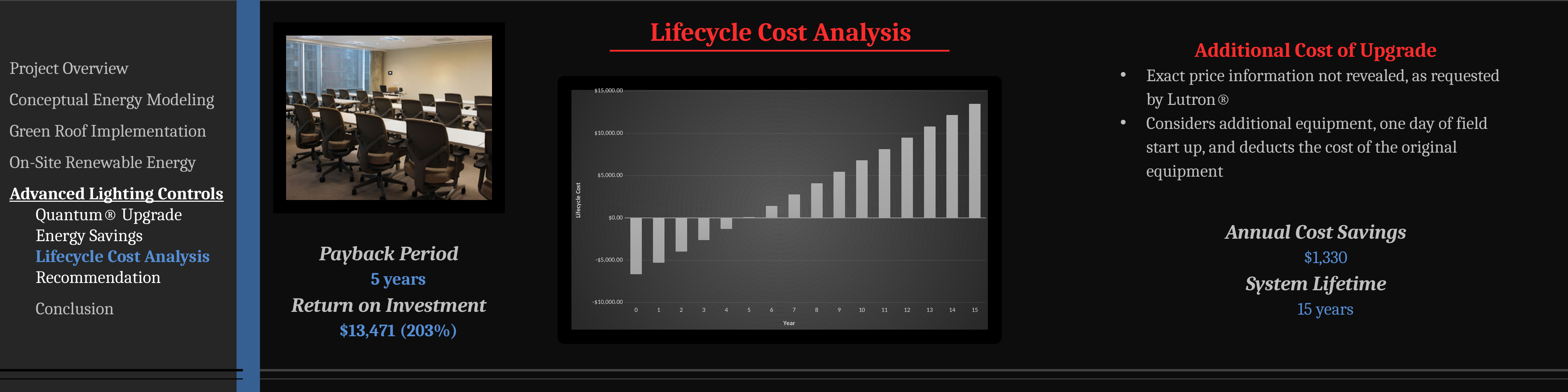
Is the value for year 10 greater or less than $5,000.00? greater What is the label on the x axis of the chart? Year Is the value for year 0 greater or less than -$5,000.00? less Which has the larger lifecycle cost value, year 14 or year 8? year 14 Which year has the highest lifecycle cost value in the chart? 15 Is the value for year 12 greater or less than $10,000.00? less What is the label on the y axis of the chart? Lifecycle Cost How many years are plotted along the x axis of the chart? 16 What kind of chart is shown on the slide? bar chart Which year has the lowest lifecycle cost value in the chart? 0 Do the lifecycle cost values rise or fall as the year increases along the x axis? rise